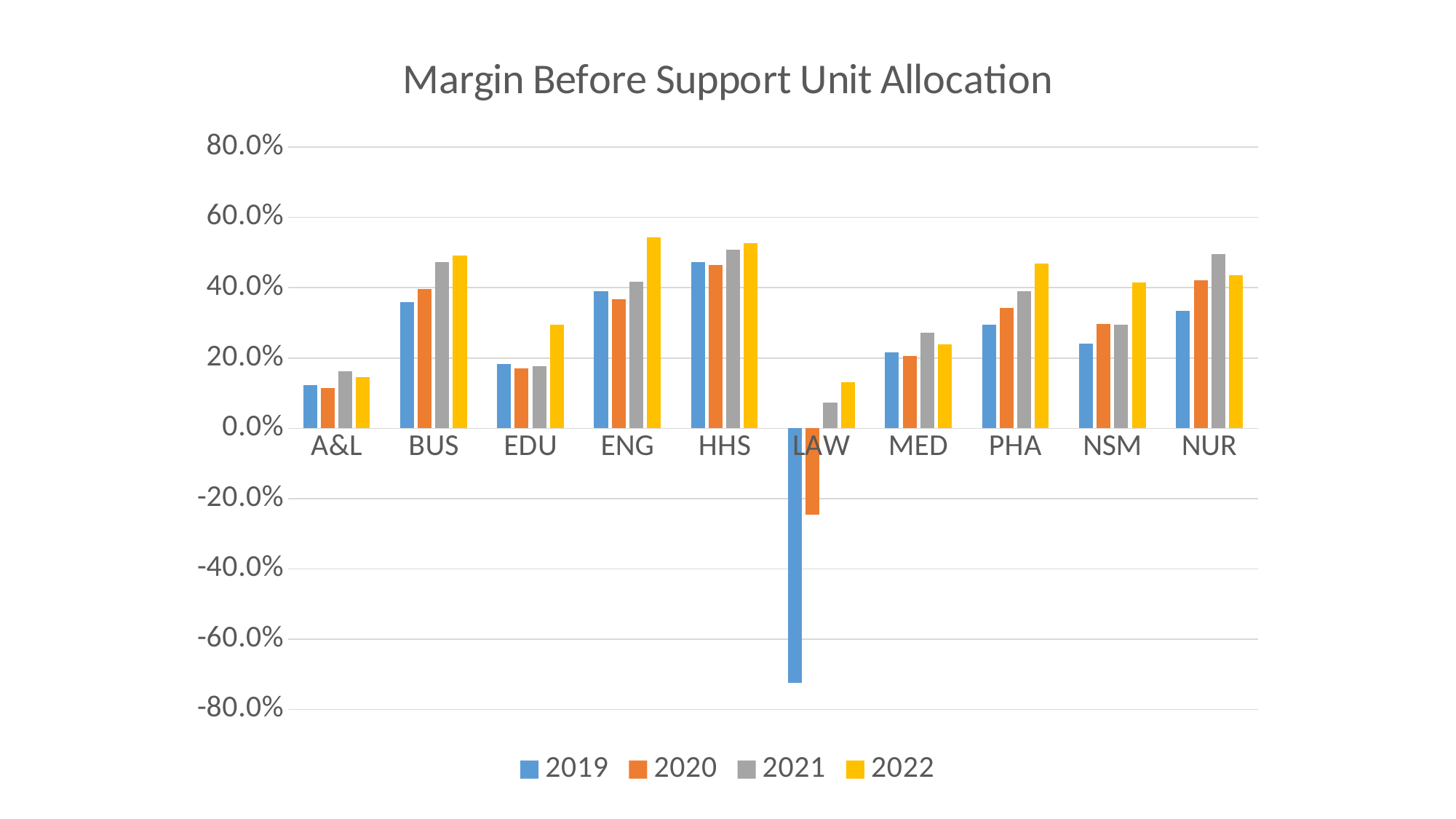
Do the values for LAW rise or fall from 2019 to 2022? rise Which is larger, the 2022 value for BUS or the 2022 value for A&L? BUS Which category has the lowest value for 2021? LAW Is the 2022 value for ENG greater or less than 40.0%? greater What is the title of the chart? Margin Before Support Unit Allocation Which category has the highest value for 2019? HHS Is the 2019 value for LAW greater or less than -60.0%? less Is the 2019 value for EDU greater or less than 20.0%? less What kind of chart is shown on the slide? bar chart How many series does the legend list? 4 Which category has the lowest value for 2019? LAW How many categories are shown on the x axis? 10